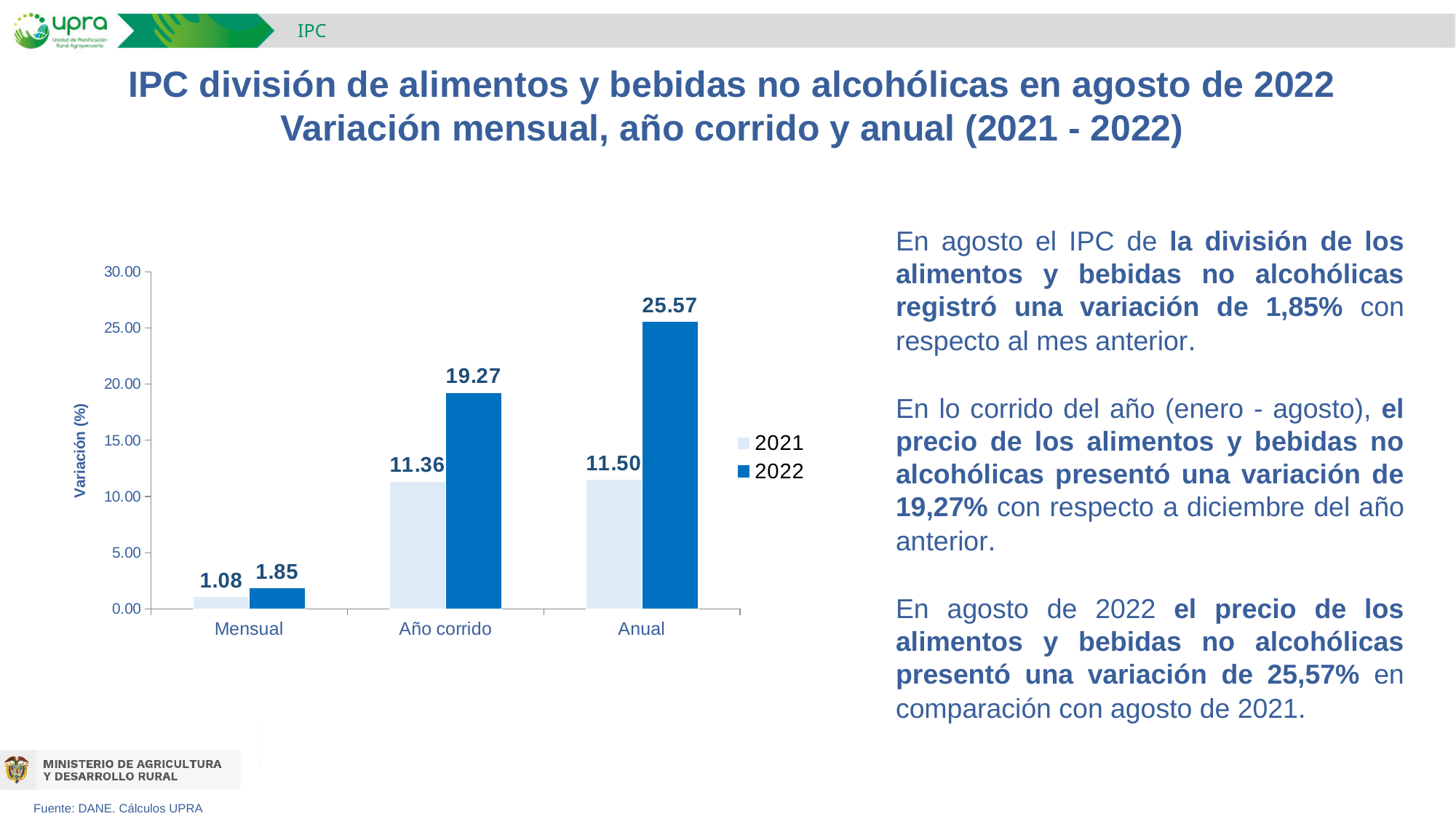
Which is larger in the Mensual category, the 2021 value or the 2022 value? 2022 What kind of chart is shown on the slide? Bar chart What is the difference between the 2022 and 2021 values in the Año corrido category? 7.91 Which category has the highest value for the 2022 series? Anual What is the value for 2021 in the Año corrido category? 11.36 What is the value for 2022 in the Anual category? 25.57 How many categories are shown on the x axis? 3 What is the difference between the 2022 and 2021 values in the Anual category? 14.07 What is the value for 2022 in the Mensual category? 1.85 What is the value for 2021 in the Anual category? 11.50 How many series does the legend list? 2 Which category has the lowest value for the 2021 series? Mensual